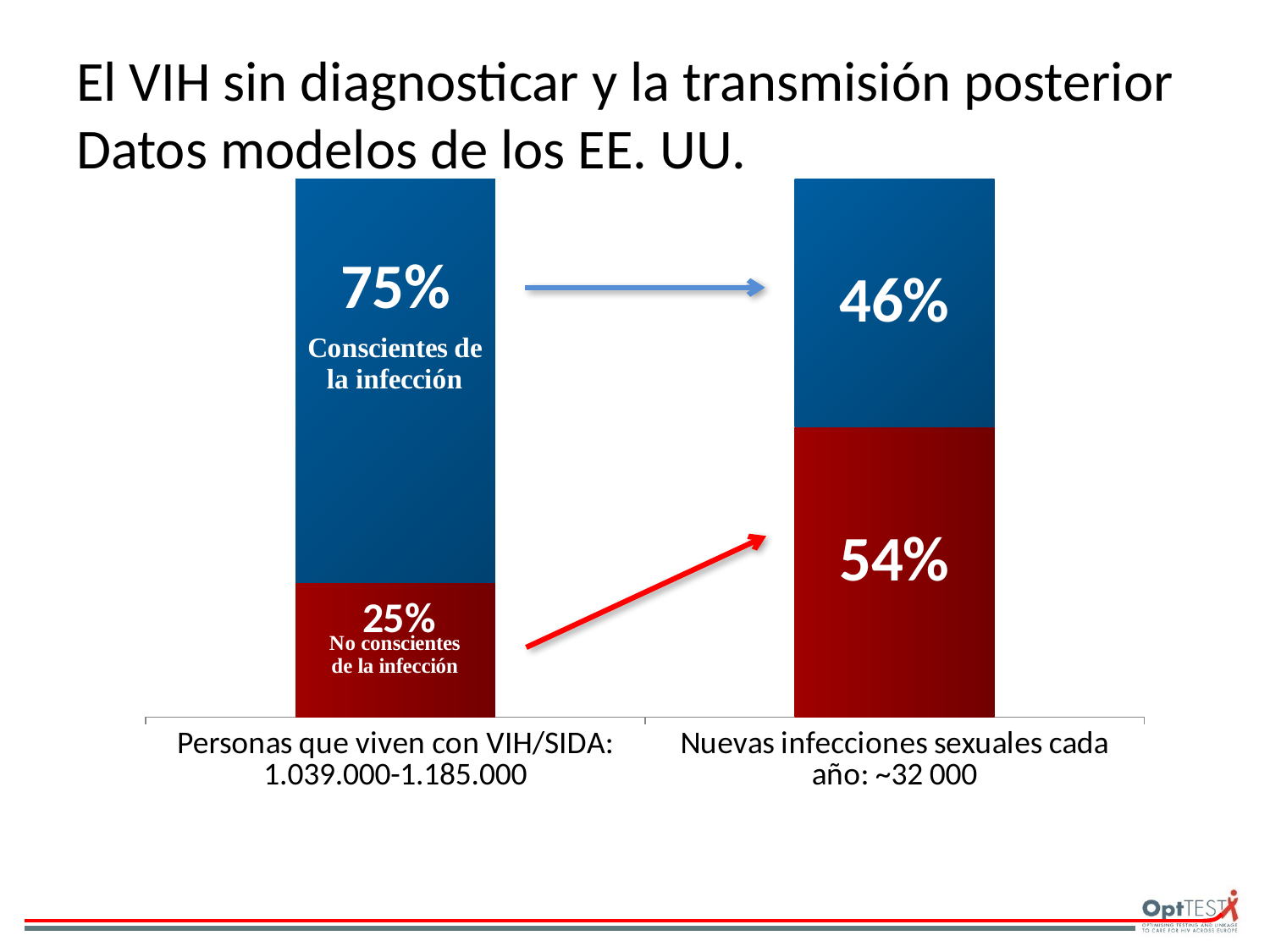
What range of people living with HIV/AIDS is given in the first category label? 1.039.000-1.185.000 How many bars are shown in the chart? 2 What share of new sexual infections each year is attributed to the blue (aware) segment? 46% In the 'Nuevas infecciones sexuales cada año' bar, which segment is larger, the blue or the red? red What percentage of people living with HIV/AIDS are shown as 'No conscientes de la infección'? 25% What is the difference between the aware and unaware percentages in the 'Personas que viven con VIH/SIDA' bar? 50% What is the total of the two segments in the 'Personas que viven con VIH/SIDA' bar? 100% What is the difference between the red and blue segments in the 'Nuevas infecciones sexuales cada año' bar? 8% What type of chart is shown on the slide? stacked bar chart What percentage of people living with HIV/AIDS are shown as 'Conscientes de la infección'? 75% What share of new sexual infections each year is attributed to the red (unaware) segment? 54% Which bar has the larger red segment, 'Personas que viven con VIH/SIDA' or 'Nuevas infecciones sexuales cada año'? Nuevas infecciones sexuales cada año